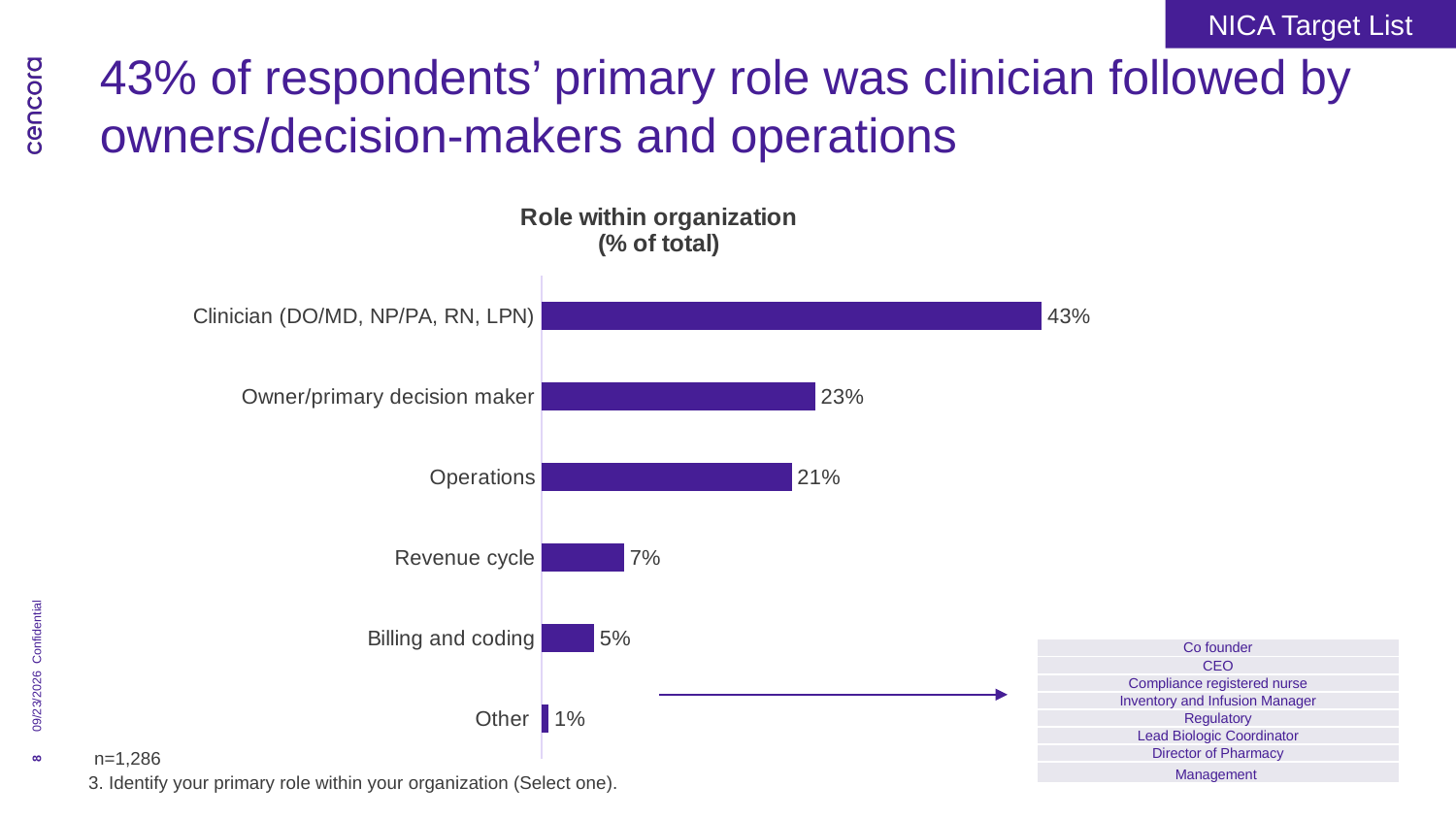
Which role category has the highest percentage? Clinician (DO/MD, NP/PA, RN, LPN) Which role category has the lowest percentage? Other What is the sample size (n) shown below the chart? n=1,286 What is the title of the chart? Role within organization (% of total) What percentage of respondents reported Clinician (DO/MD, NP/PA, RN, LPN) as their primary role? 43% Which is larger, the value for Revenue cycle or the value for Billing and coding? Revenue cycle What is the difference between the Clinician value and the Billing and coding value? 38% What is the value for Owner/primary decision maker? 23% How many role categories are shown in the chart? 6 What type of chart is used to show role within organization? Bar chart What is the value for Revenue cycle? 7% What is the difference in percentage points between Owner/primary decision maker and Operations? 2%